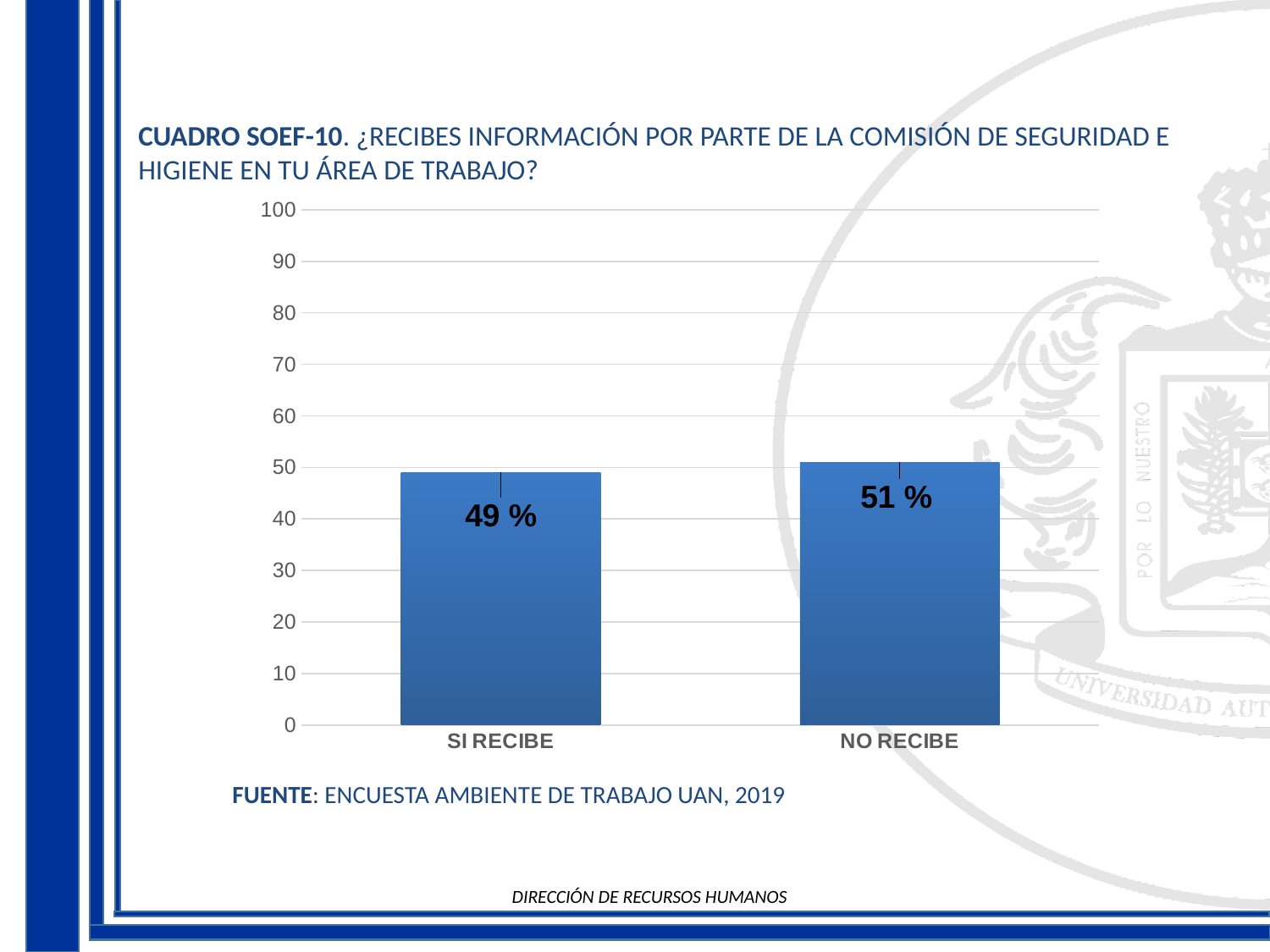
Which category has the highest value? NO RECIBE Which is larger, the value for SI RECIBE or the value for NO RECIBE? NO RECIBE What is the maximum value shown on the y axis? 100 Which category has the lowest value? SI RECIBE How many categories are shown on the x axis? 2 What is the value for NO RECIBE? 51 % What is the difference between the values for NO RECIBE and SI RECIBE? 2 % Is the value for SI RECIBE greater or less than 50? less What kind of chart is shown on the slide? bar chart Is the value for NO RECIBE greater or less than 50? greater What is the value for SI RECIBE? 49 % What source is cited below the chart? ENCUESTA AMBIENTE DE TRABAJO UAN, 2019